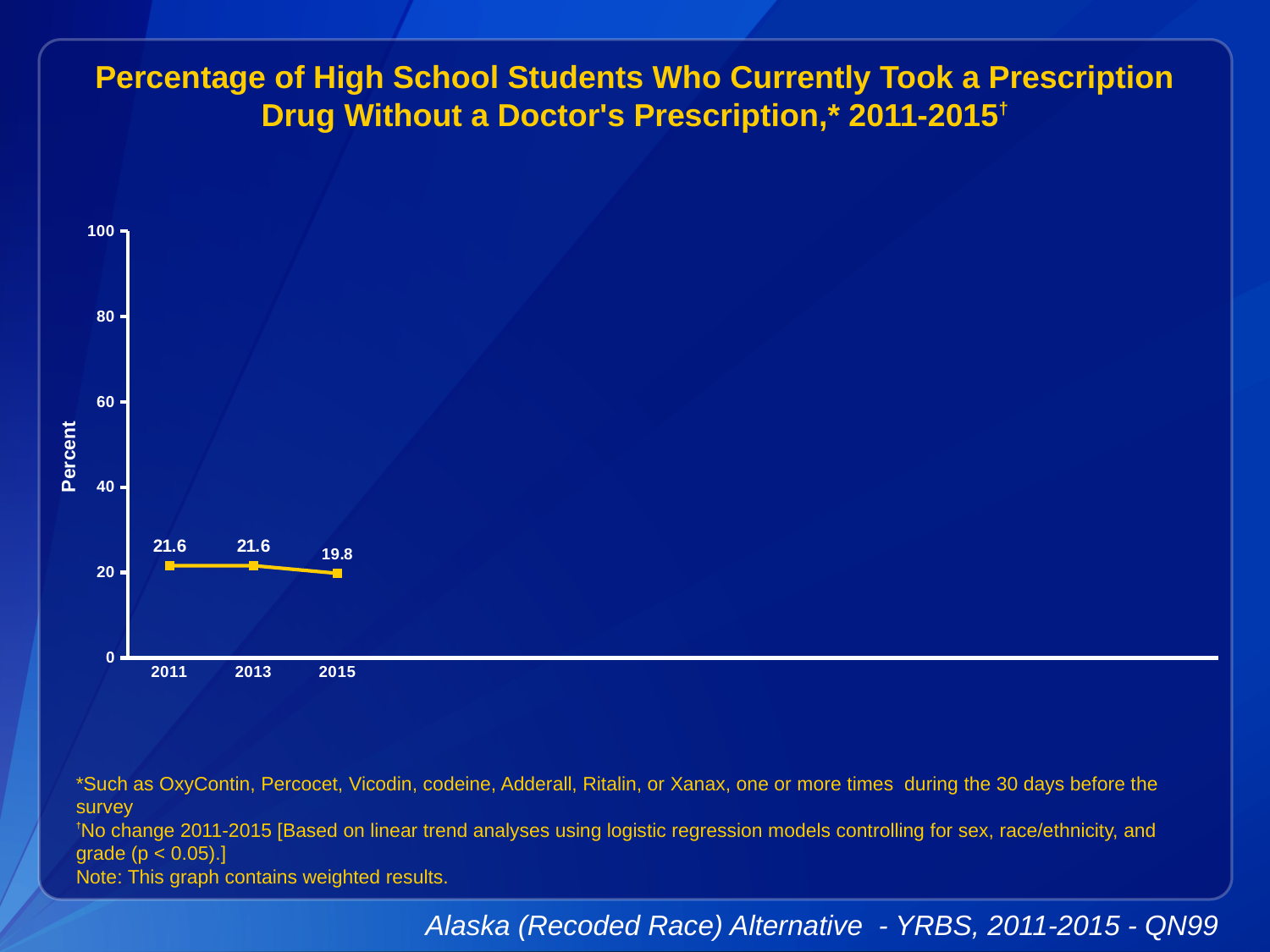
How many years are plotted on the chart? 3 Is the value for 2011 greater or less than 40? less Is the value for 2015 greater or less than 20? less Which year has the lowest value? 2015 What is the label on the y axis? Percent Which is larger, the value for 2011 or the value for 2015? 2011 What is the value for 2011? 21.6 Do the values rise or fall from 2013 to 2015? fall What is the difference between the values for 2013 and 2015? 1.8 What is the value for 2013? 21.6 What is the value for 2015? 19.8 What kind of chart is shown on the slide? line chart